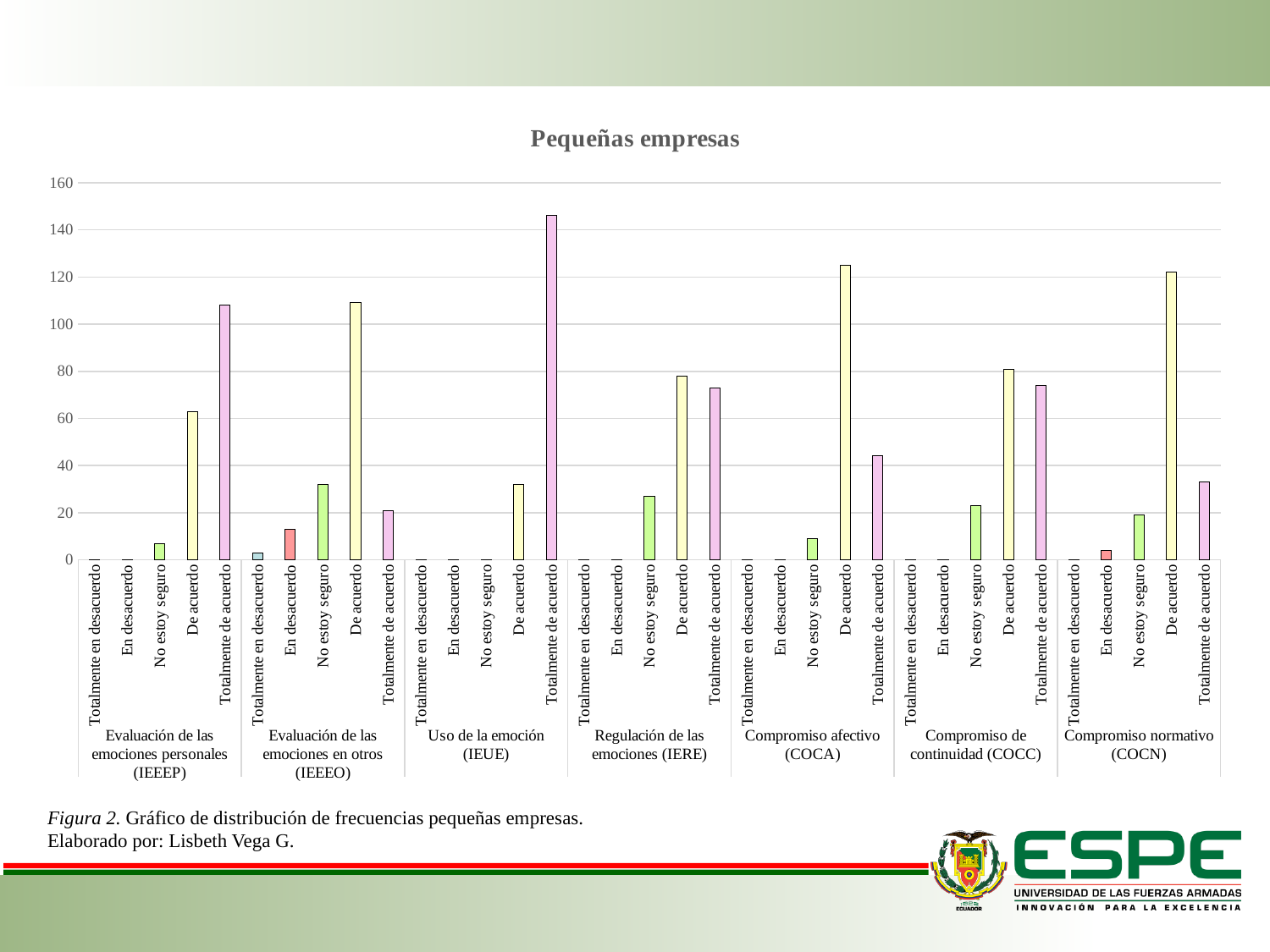
In Evaluación de las emociones personales (IEEEP), which is larger: De acuerdo or Totalmente de acuerdo? Totalmente de acuerdo How many response categories are shown within each dimension group? 5 What type of chart is shown on the slide? Bar chart Is the value for Totalmente de acuerdo in Compromiso afectivo (COCA) greater or less than 60? less What is the highest value shown on the y axis? 160 Is the value for De acuerdo in Compromiso afectivo (COCA) greater or less than 120? greater Is the value for De acuerdo in Evaluación de las emociones personales (IEEEP) greater or less than 80? less In Evaluación de las emociones en otros (IEEEO), which is larger: De acuerdo or Totalmente de acuerdo? De acuerdo What is the title of the chart? Pequeñas empresas Which bar is the tallest in the whole chart? Totalmente de acuerdo in Uso de la emoción (IEUE) How many dimension groups (such as IEEEP, IEEEO, IEUE) are shown along the x axis? 7